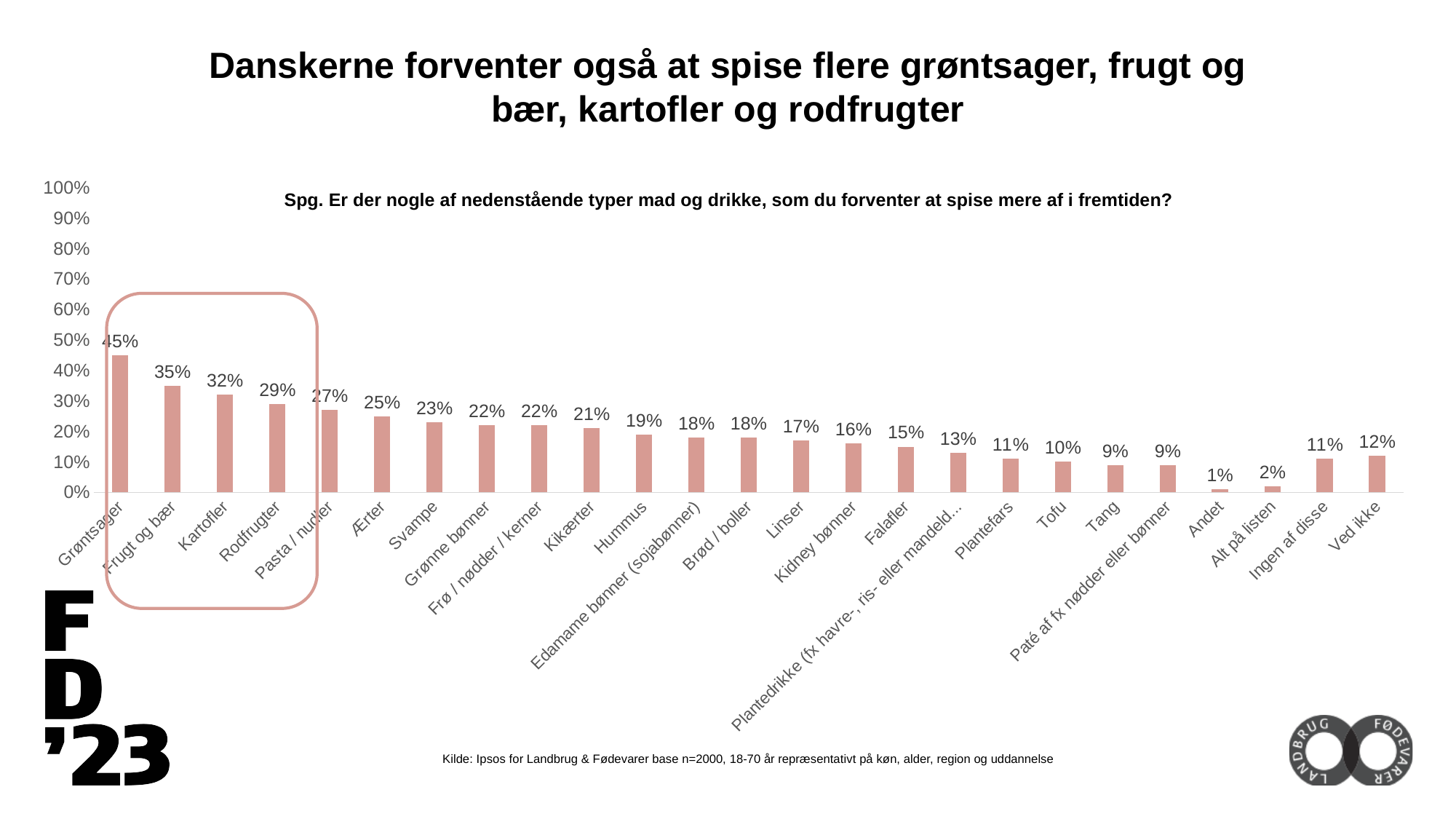
Which category has the lowest value? Andet What is the value for Ved ikke? 12% What is the value for Kartofler? 32% What is the value for Grøntsager? 45% What is the highest value shown on the y axis? 100% Which is larger, the value for Rodfrugter or the value for Pasta / nudler? Rodfrugter What kind of chart is shown on the slide? Bar chart Which category has the highest value? Grøntsager Is the value for Ærter greater or less than 20%? greater How many categories are shown on the x axis? 25 What is the value for Tofu? 10% What is the difference between the values for Grøntsager and Frugt og bær? 10%